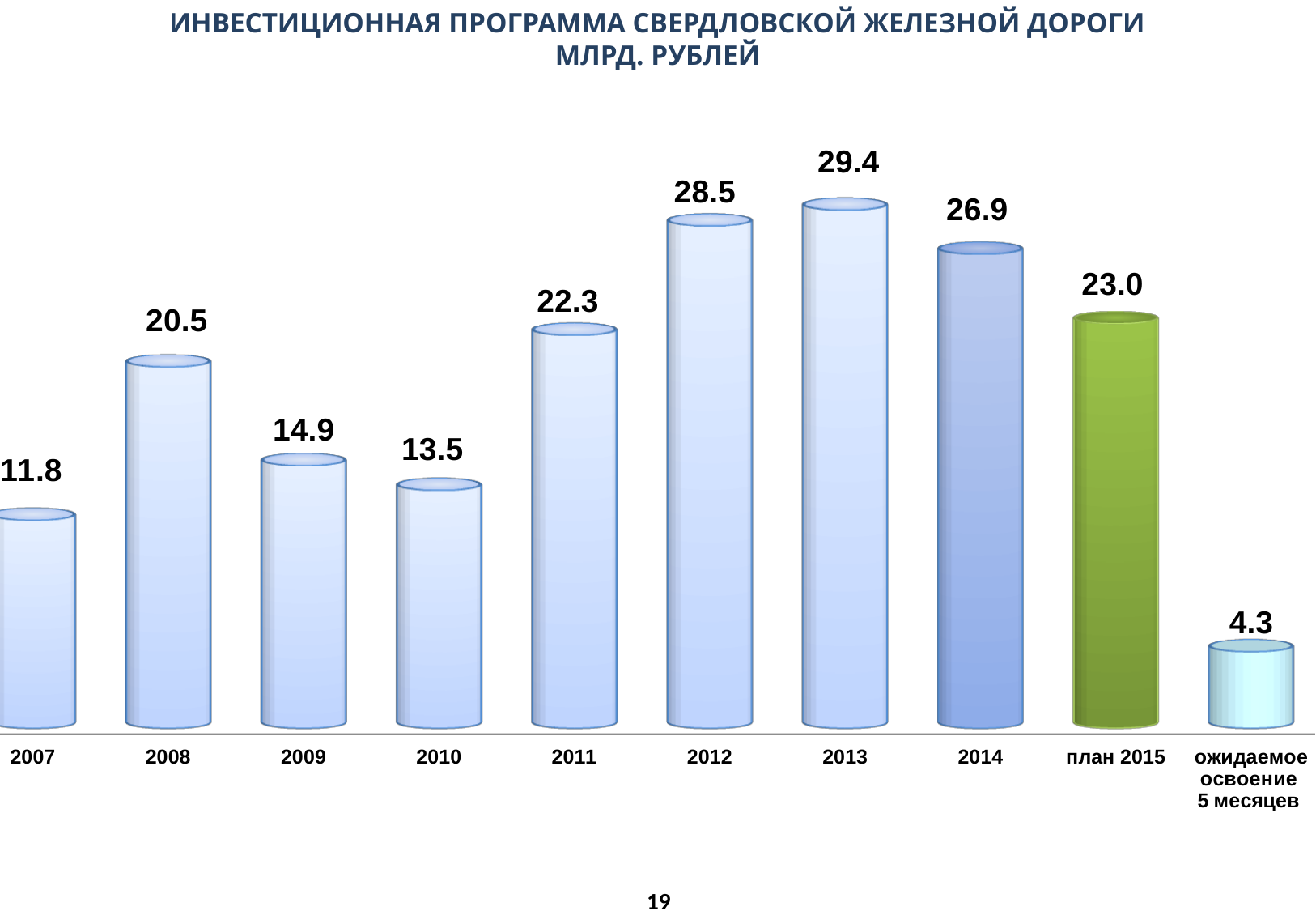
What is the title of the chart? ИНВЕСТИЦИОННАЯ ПРОГРАММА СВЕРДЛОВСКОЙ ЖЕЛЕЗНОЙ ДОРОГИ МЛРД. РУБЛЕЙ What is the value for ожидаемое освоение 5 месяцев? 4.3 Which category has the highest value? 2013 Which category has the lowest value? ожидаемое освоение 5 месяцев What is the value for план 2015? 23.0 What is the difference between the values for 2013 and 2014? 2.5 What kind of chart is shown on the slide? bar chart What is the value for 2013? 29.4 What is the difference between the values for 2008 and 2007? 8.7 Which is larger, the value for 2011 or the value for 2010? 2011 How many bars are shown in the chart? 10 Do the values rise or fall from 2010 to 2013? rise